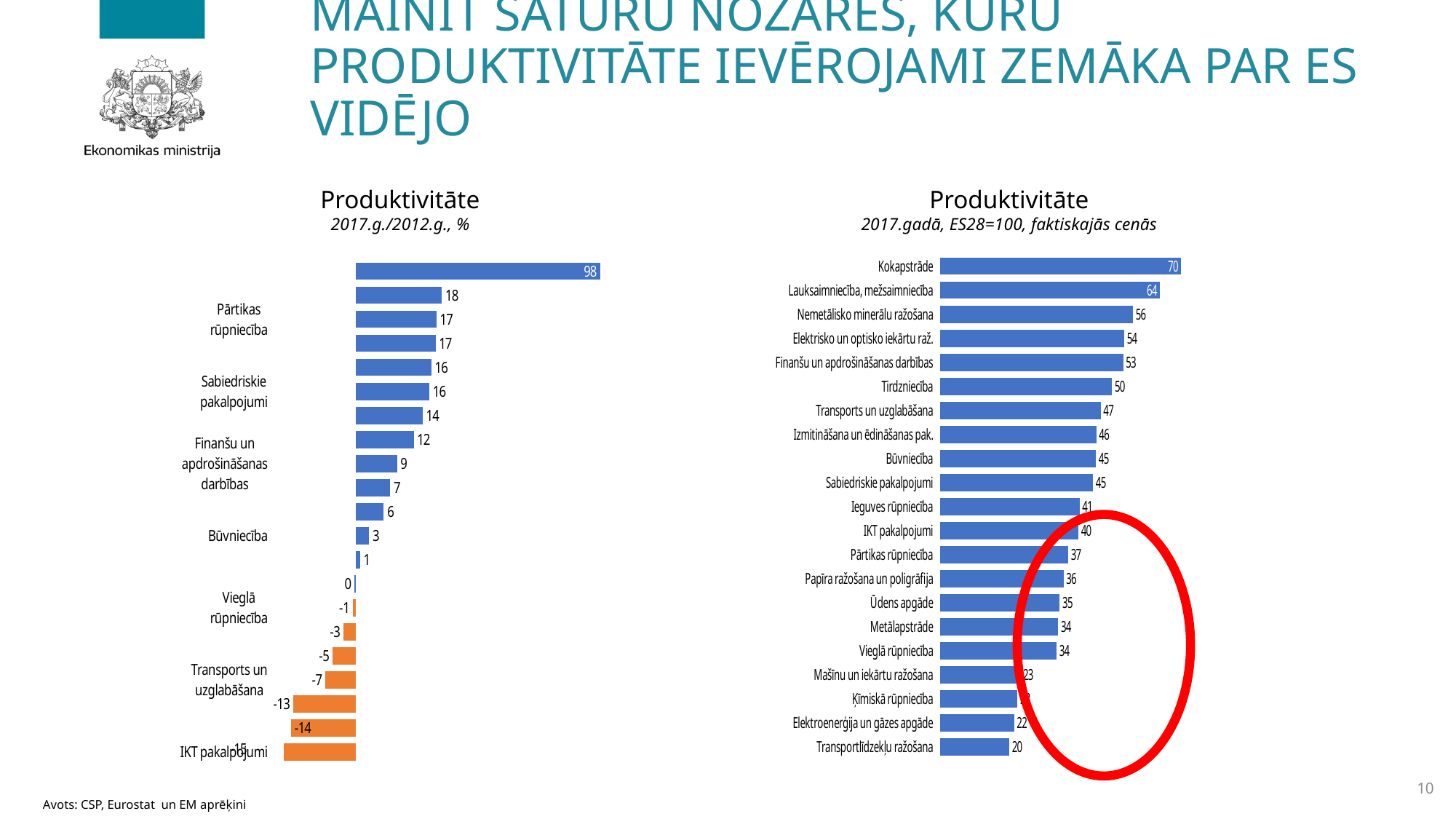
In the right chart (Produktivitāte 2017.gadā, ES28=100), which is larger: Pārtikas rūpniecība or IKT pakalpojumi? IKT pakalpojumi In the right chart (Produktivitāte 2017.gadā, ES28=100), what is the value for Kokapstrāde? 70 In the right chart (Produktivitāte 2017.gadā, ES28=100), what is the difference between Kokapstrāde and Lauksaimniecība, mežsaimniecība? 6 What kind of chart is the right chart (Produktivitāte 2017.gadā, ES28=100)? Bar chart In the right chart (Produktivitāte 2017.gadā, ES28=100), how many categories are shown? 21 In the right chart (Produktivitāte 2017.gadā, ES28=100), what is the value for Transportlīdzekļu ražošana? 20 In the right chart (Produktivitāte 2017.gadā, ES28=100), which category has the highest value? Kokapstrāde In the right chart (Produktivitāte 2017.gadā, ES28=100), what is the value for Tirdzniecība? 50 In the left chart (Produktivitāte 2017.g./2012.g., %), what is the highest value shown? 98 In the left chart (Produktivitāte 2017.g./2012.g., %), what colour are the bars with negative values? Orange In the right chart (Produktivitāte 2017.gadā, ES28=100), which category has the lowest value? Transportlīdzekļu ražošana In the left chart (Produktivitāte 2017.g./2012.g., %), how many bars are shown? 21